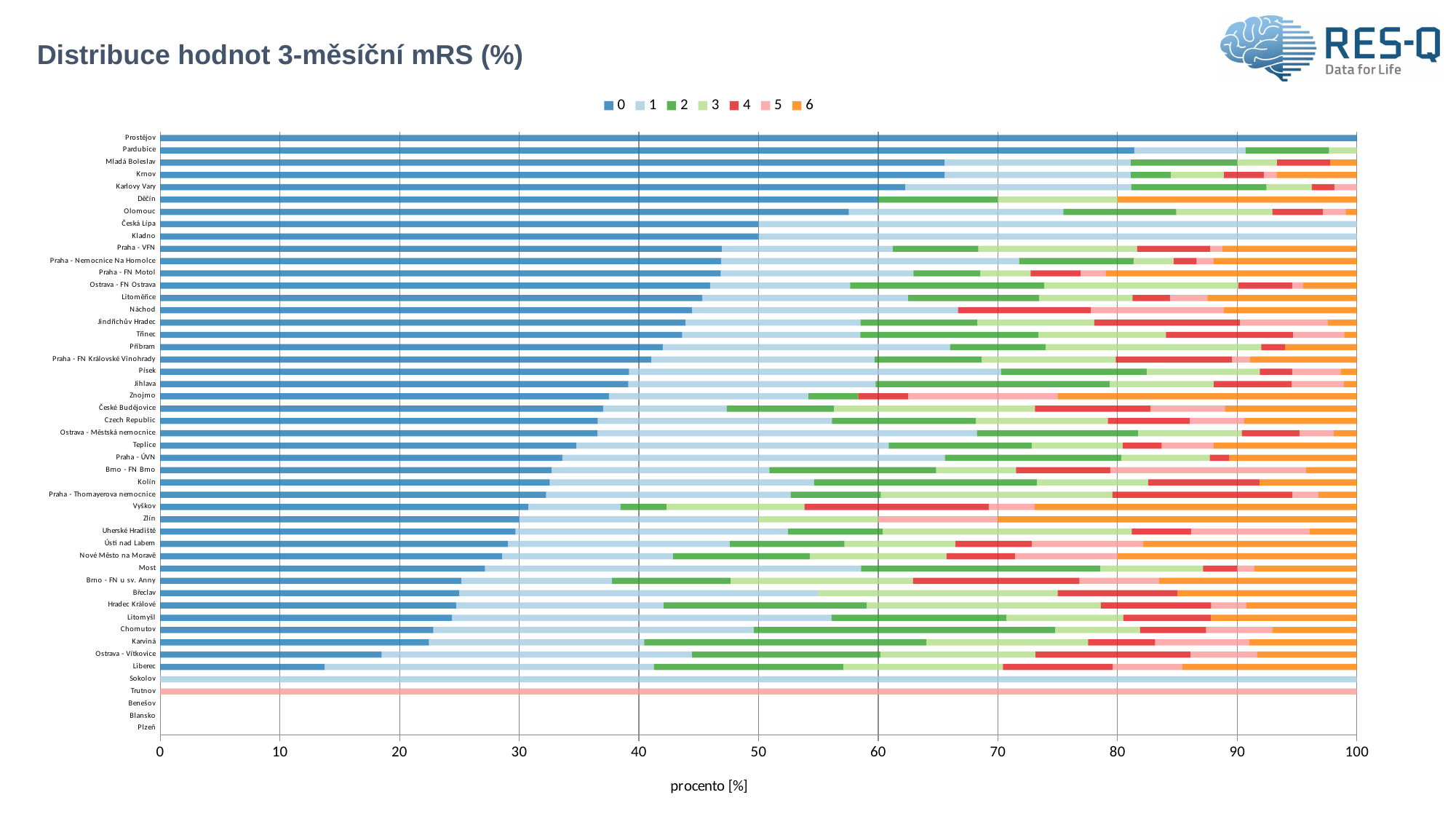
What kind of chart is shown on the slide? stacked bar chart Is the value of series 0 for Liberec greater or less than 20? less What is the title of the chart? Distribuce hodnot 3-měsíční mRS (%) How many categories (hospitals/regions) are listed on the vertical axis? 49 Is the value of series 0 for Pardubice greater or less than 60? greater Is the value of series 0 for Karlovy Vary greater or less than 60? greater How many series does the legend list? 7 What is the value of series 5 for Trutnov? 100 What is the label of the horizontal axis? procento [%] What is the value of series 0 for Prostějov? 100 Which has a larger value for series 0, Pardubice or Liberec? Pardubice Which category has the highest value for series 0? Prostějov